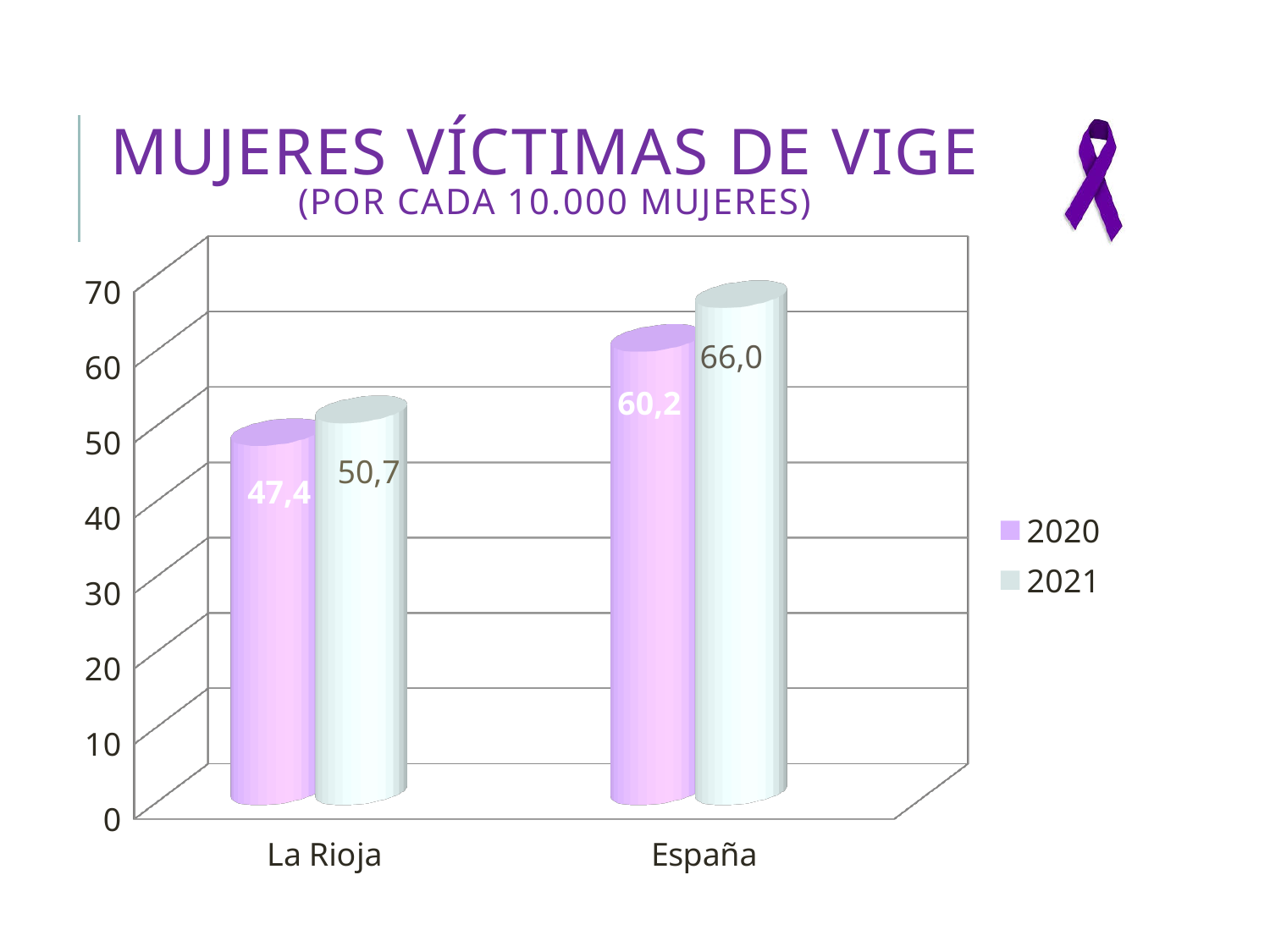
Which category has the lowest value in the 2020 series? La Rioja What is the difference between the 2021 and 2020 values for España? 5,8 How many series does the legend list? 2 What is the difference between the 2021 and 2020 values for La Rioja? 3,3 What is the value for La Rioja in 2020? 47,4 Which is larger: the 2020 value for España or the 2021 value for La Rioja? 2020 value for España Which category has the highest value in the 2021 series? España What is the value for España in 2021? 66,0 What is the value for España in 2020? 60,2 How many categories are shown on the x axis? 2 What kind of chart is shown on the slide? Bar chart What is the value for La Rioja in 2021? 50,7